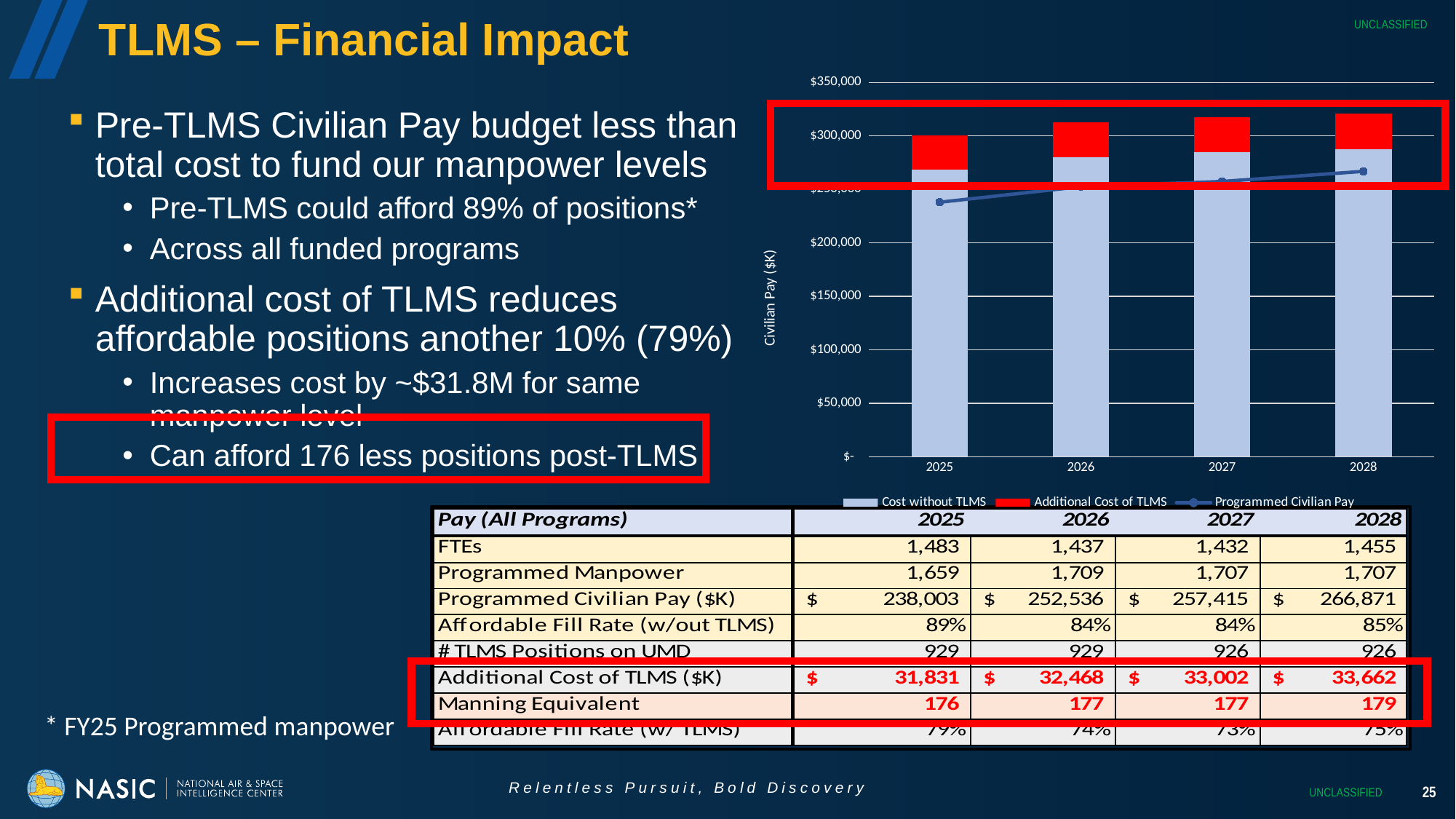
How many years are shown on the x axis of the chart? 4 What is the label on the chart's vertical axis? Civilian Pay ($K) Is the Programmed Civilian Pay value for 2028 greater or less than $250,000? greater Which year has the shortest total bar in the chart? 2025 Is the total bar height (Cost without TLMS plus Additional Cost of TLMS) for 2028 greater or less than $300,000? greater What kind of chart is shown on the slide? Stacked bar chart with a line series Does the Programmed Civilian Pay line rise or fall from 2025 to 2028? Rise Which year has the tallest total bar in the chart? 2028 Is the Cost without TLMS value for 2028 greater or less than $300,000? less Which colour represents Additional Cost of TLMS in the chart? Red How many series does the chart legend list? 3